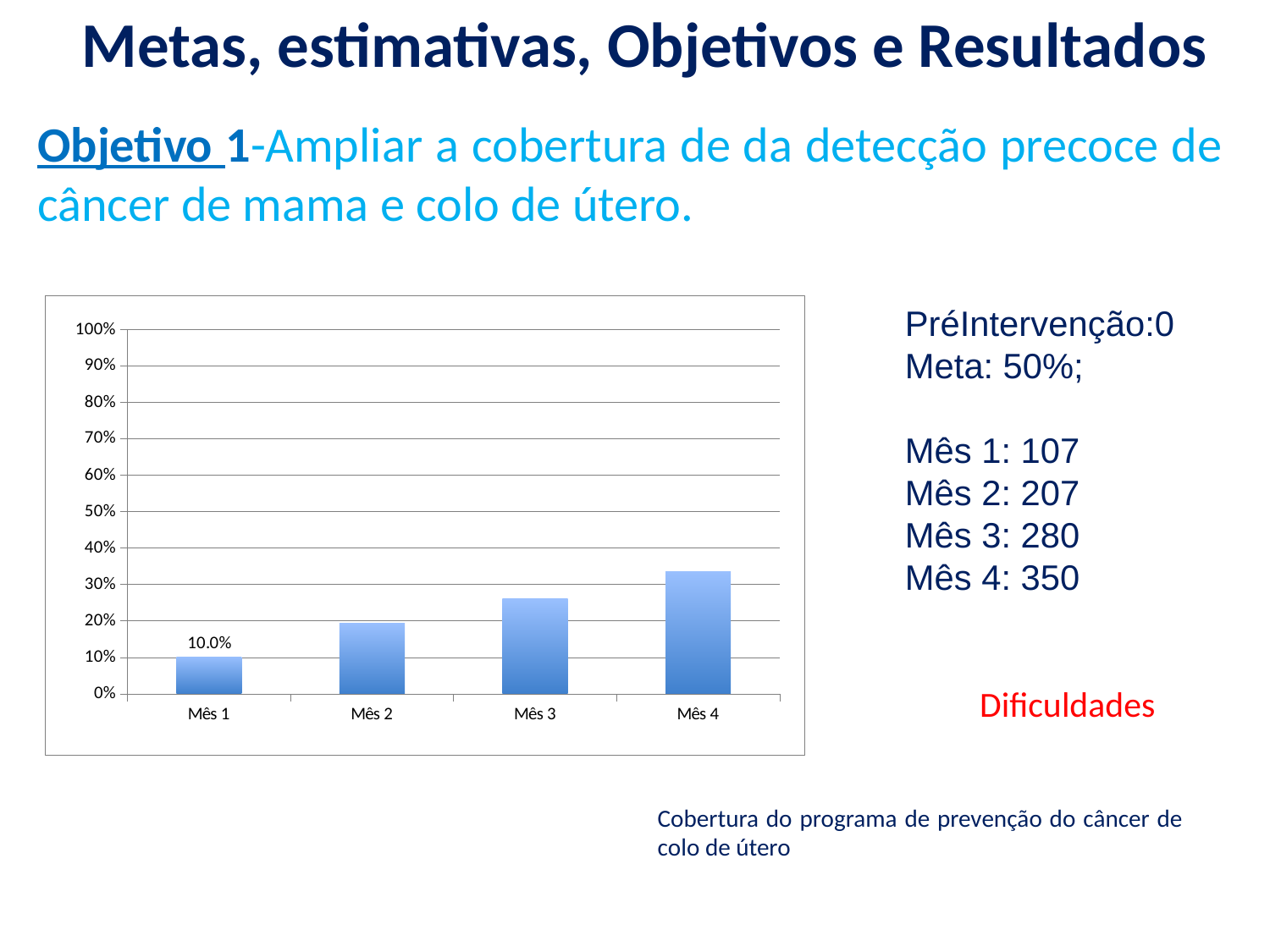
Which month has the highest bar? Mês 4 Which month has the lowest bar? Mês 1 Is the value for Mês 2 greater or less than 10%? greater Which is larger, the value for Mês 3 or the value for Mês 2? Mês 3 What kind of chart is shown on the slide? Bar chart Do the values rise or fall from Mês 1 to Mês 4? Rise What is the highest value shown on the y axis? 100% What is the value shown for Mês 1? 10.0% How many months (categories) are plotted on the x axis? 4 Is the value for Mês 4 greater or less than 30%? greater Is the value for Mês 3 greater or less than 30%? less